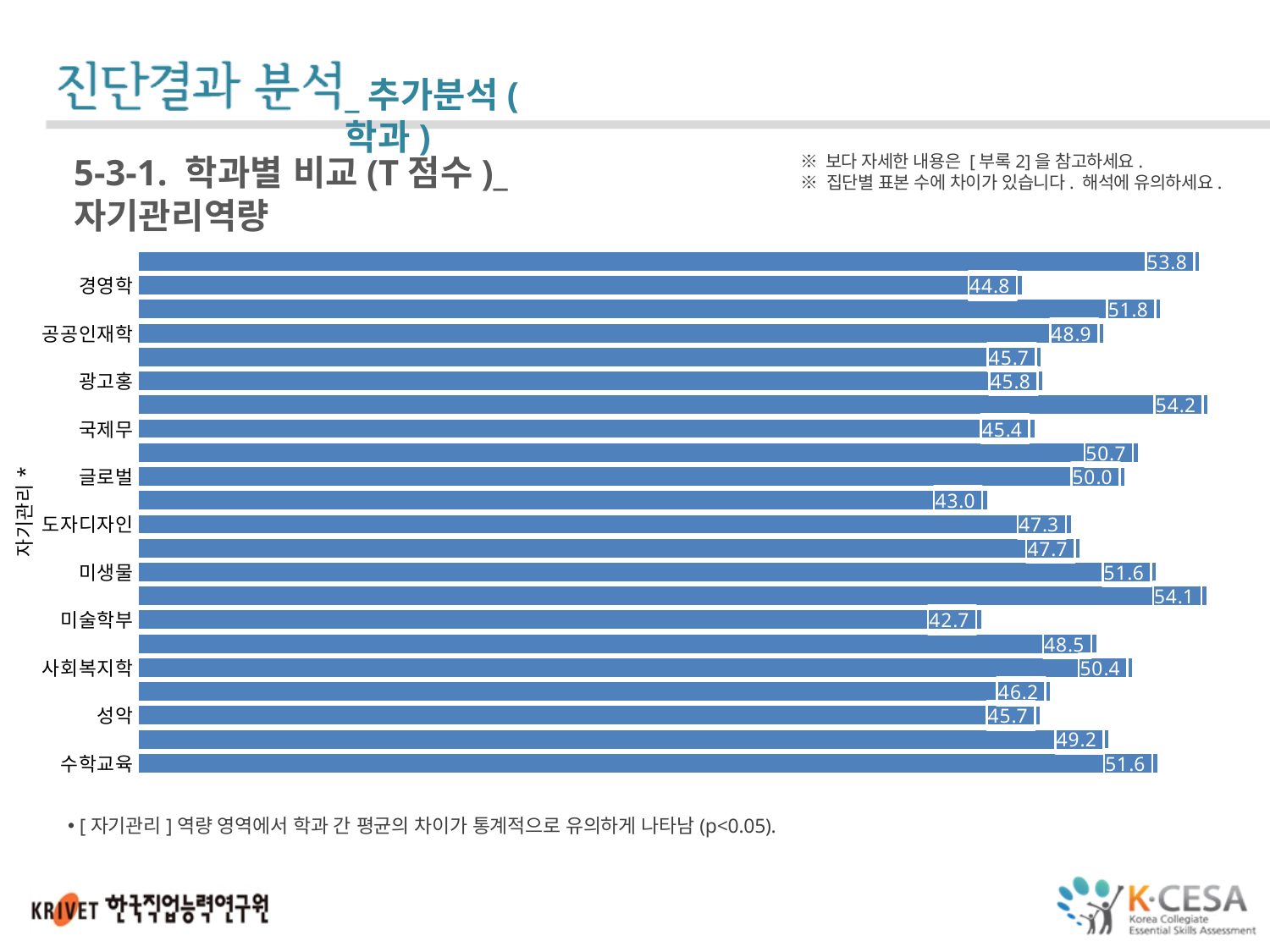
How many category labels are shown on the vertical axis of the chart? 11 What is the value of the bar labelled 경영학? 44.8 How many bars are plotted in the chart? 22 What is the difference between the topmost bar's value (53.8) and the bar labelled 경영학 (44.8)? 9.0 What kind of chart is shown on the slide? bar chart What is the label on the vertical axis of the chart? 자기관리 * What is the highest value shown on any bar in the chart? 54.2 What is the value of the bar labelled 미술학부? 42.7 What is the value of the bar labelled 사회복지학? 50.4 What is the value of the bar labelled 수학교육? 51.6 What is the lowest value shown on any bar in the chart? 42.7 Which has the larger value, the bar labelled 미술학부 or the bar labelled 수학교육? 수학교육